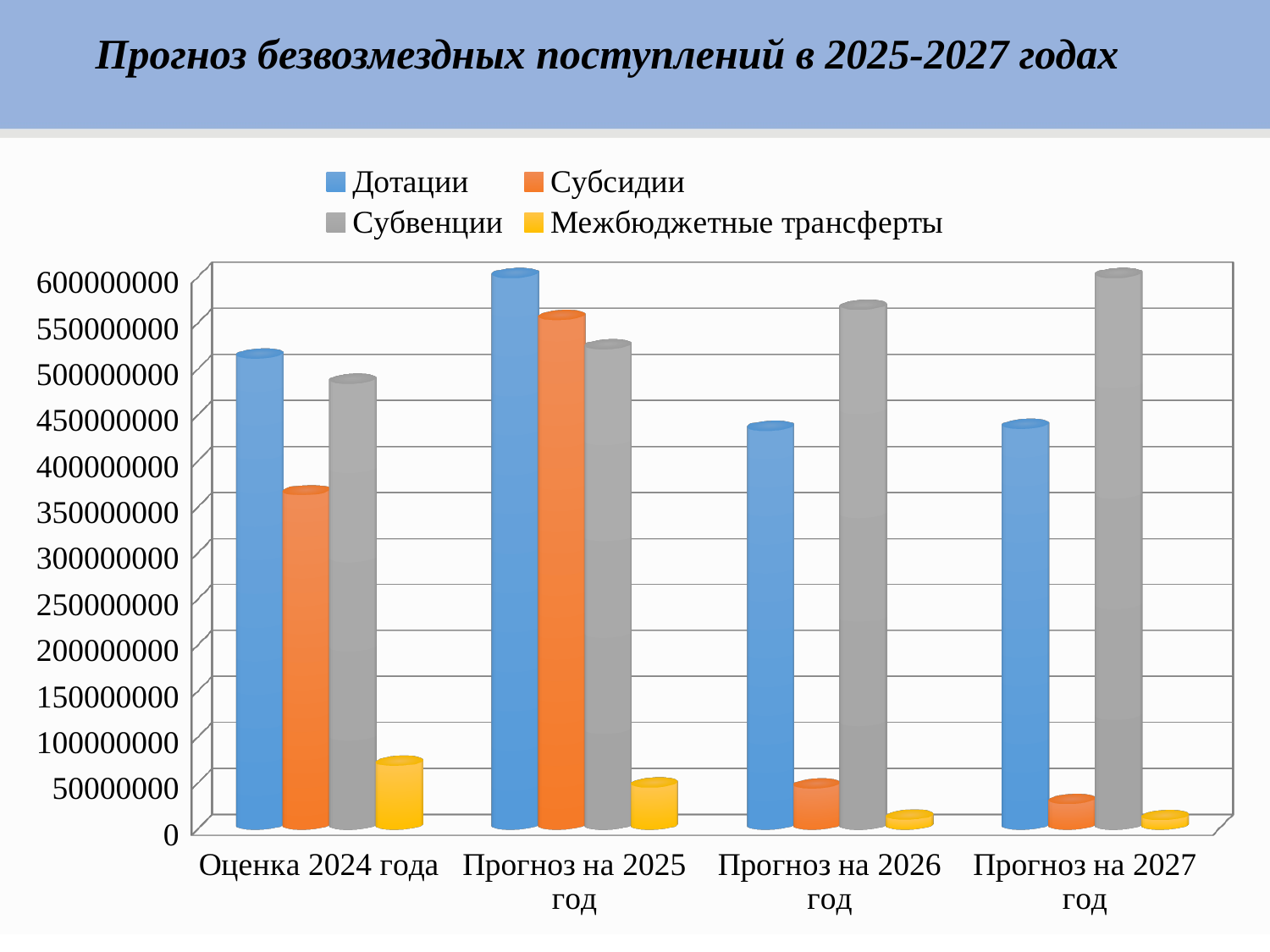
Is the value for Межбюджетные трансферты in Оценка 2024 года greater or less than 100000000? less Is the value for Субсидии in Оценка 2024 года greater or less than 400000000? less Is the value for Дотации in Прогноз на 2025 год greater or less than 550000000? greater Which series has the lowest value in Прогноз на 2027 год? Межбюджетные трансферты What kind of chart is shown on the slide? Bar chart How many categories are shown along the x axis of the chart? 4 In which category is the value for Дотации the highest? Прогноз на 2025 год Which colour represents the series Субвенции in the chart? Grey What is the title of the slide? Прогноз безвозмездных поступлений в 2025-2027 годах How many series does the chart legend list? 4 In Прогноз на 2026 год, which is larger: Дотации or Субвенции? Субвенции